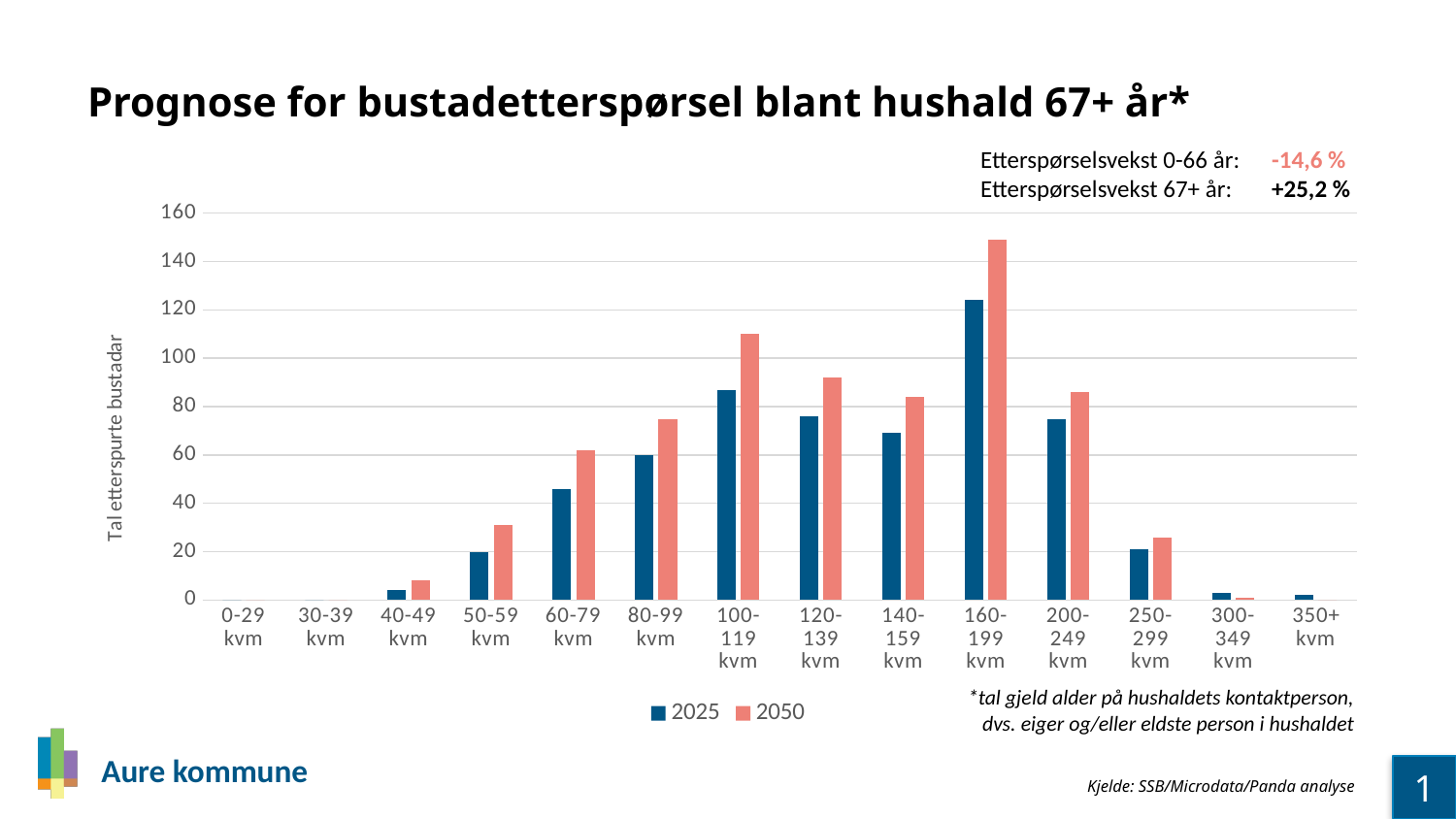
How many series does the legend list? 2 Which size category has the highest value for the 2050 series? 160-199 kvm What kind of chart is shown on the slide? bar chart Is the 2025 value for 140-159 kvm greater or less than 80? less For the 2050 series, which is larger: 60-79 kvm or 80-99 kvm? 80-99 kvm Is the 2050 value for 100-119 kvm greater or less than 100? greater For 100-119 kvm, which series has the larger value, 2025 or 2050? 2050 Is the 2050 value for 160-199 kvm greater or less than 140? greater Which size category has the highest value for the 2025 series? 160-199 kvm What is the title of the chart? Prognose for bustadetterspørsel blant hushald 67+ år* How many size categories are shown on the x axis? 14